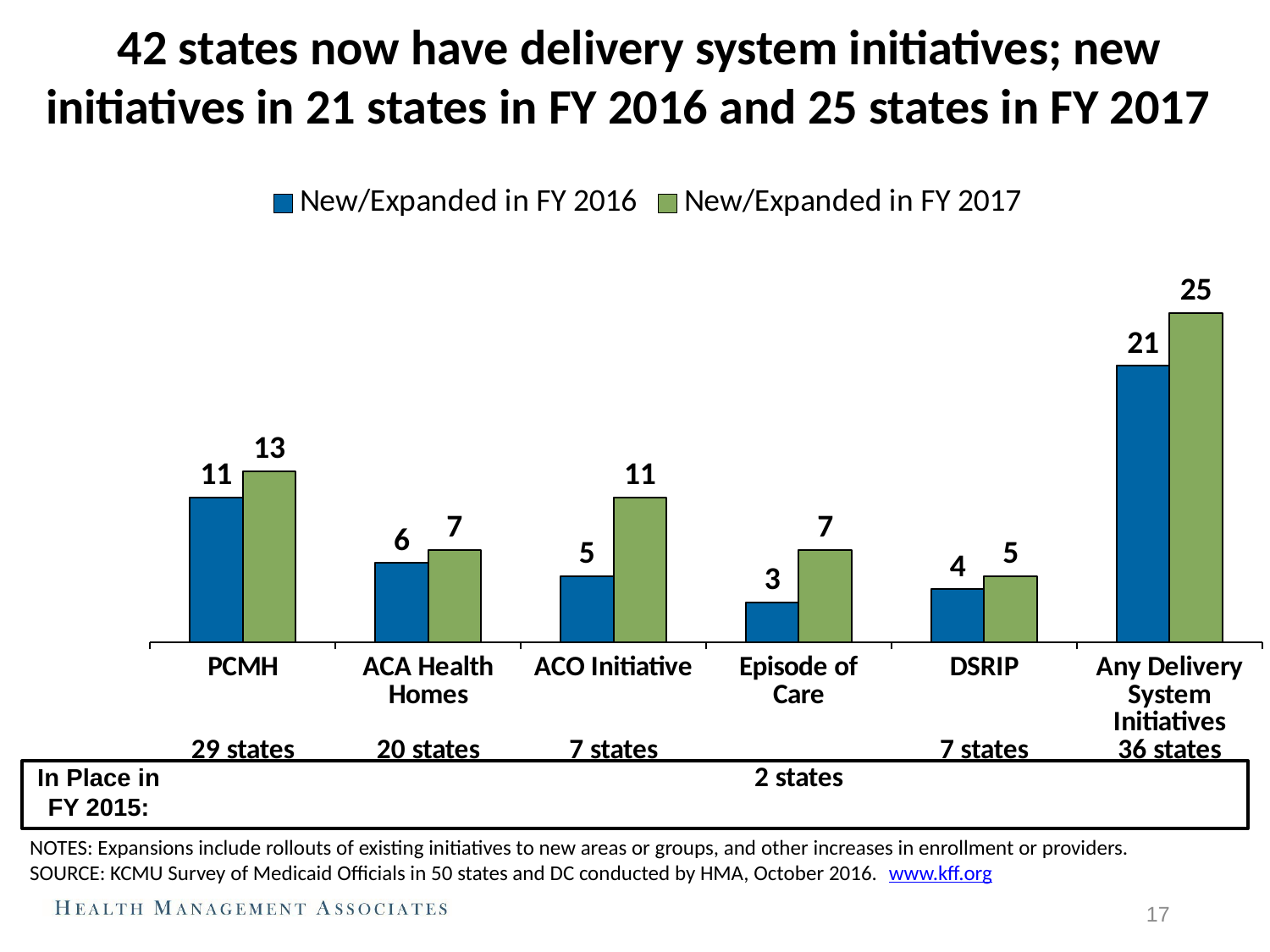
What is the difference between the FY 2017 and FY 2016 values for ACO Initiative? 6 What is the value for PCMH in the New/Expanded in FY 2016 series? 11 What is the difference between the FY 2017 and FY 2016 values for Any Delivery System Initiatives? 4 What is the value for ACO Initiative in the New/Expanded in FY 2017 series? 11 Which category has the highest value in the New/Expanded in FY 2017 series? Any Delivery System Initiatives How many categories are shown on the x axis? 6 What kind of chart is shown on the slide? Bar chart Which is larger: the FY 2016 value for ACA Health Homes or the FY 2016 value for DSRIP? ACA Health Homes Which colour represents the New/Expanded in FY 2017 series? Green Which category has the lowest value in the New/Expanded in FY 2016 series? Episode of Care How many series does the legend list? 2 What is the value for Episode of Care in the New/Expanded in FY 2016 series? 3